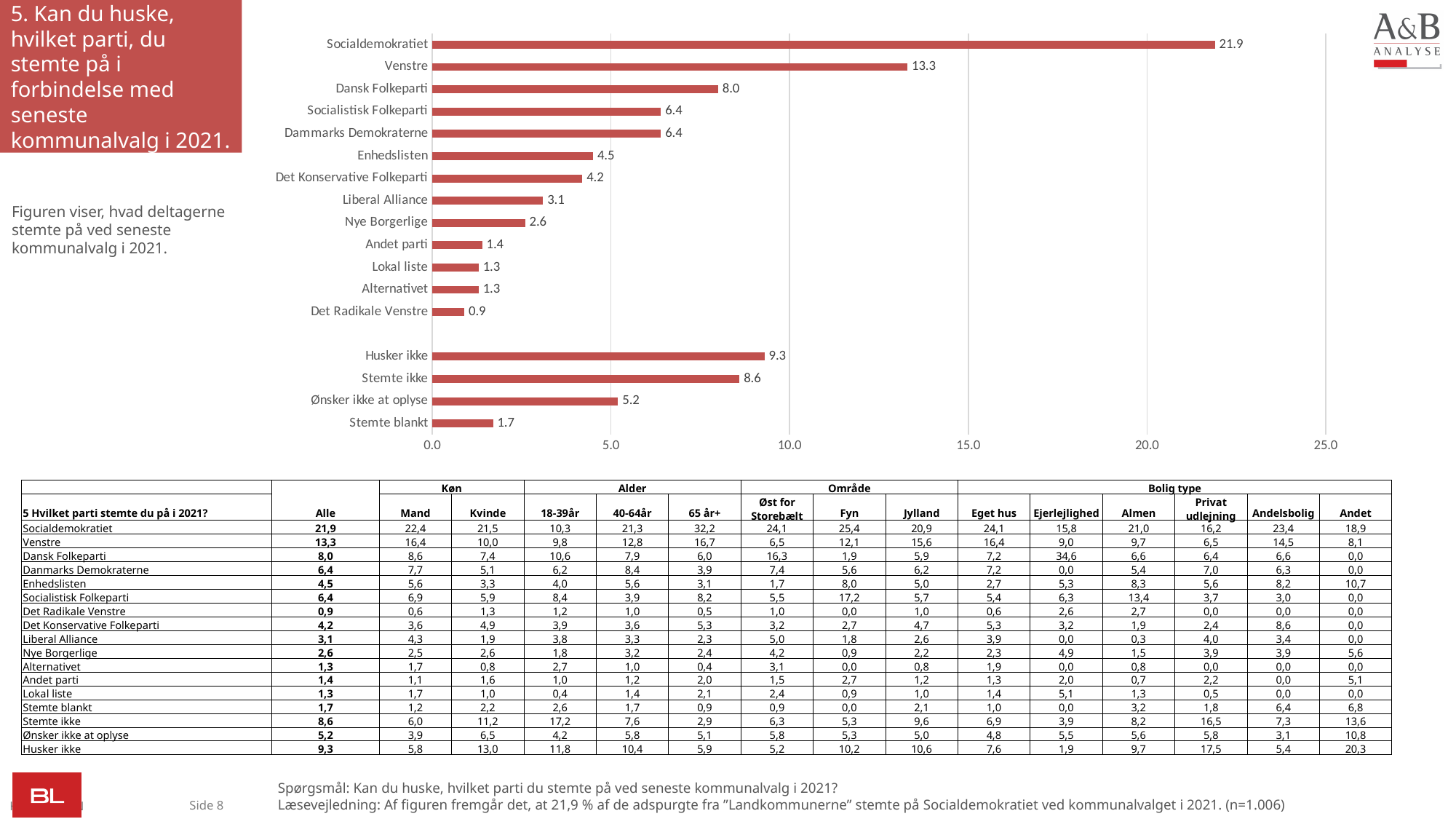
Is the value for Venstre greater or less than 10.0? greater How many bars are plotted in the chart? 17 Which is larger, the value for Dansk Folkeparti or the value for Stemte ikke? Stemte ikke What is the difference between the values for Socialdemokratiet and Venstre? 8.6 What kind of chart is shown on the slide? bar chart Which category has the lowest value in the chart? Det Radikale Venstre What is the value for Husker ikke in the chart? 9.3 What is the value for Socialdemokratiet in the chart? 21.9 What is the value for Det Konservative Folkeparti in the chart? 4.2 Which category has the highest value in the chart? Socialdemokratiet What is the highest value shown on the horizontal axis of the chart? 25.0 What is the value for Venstre in the chart? 13.3